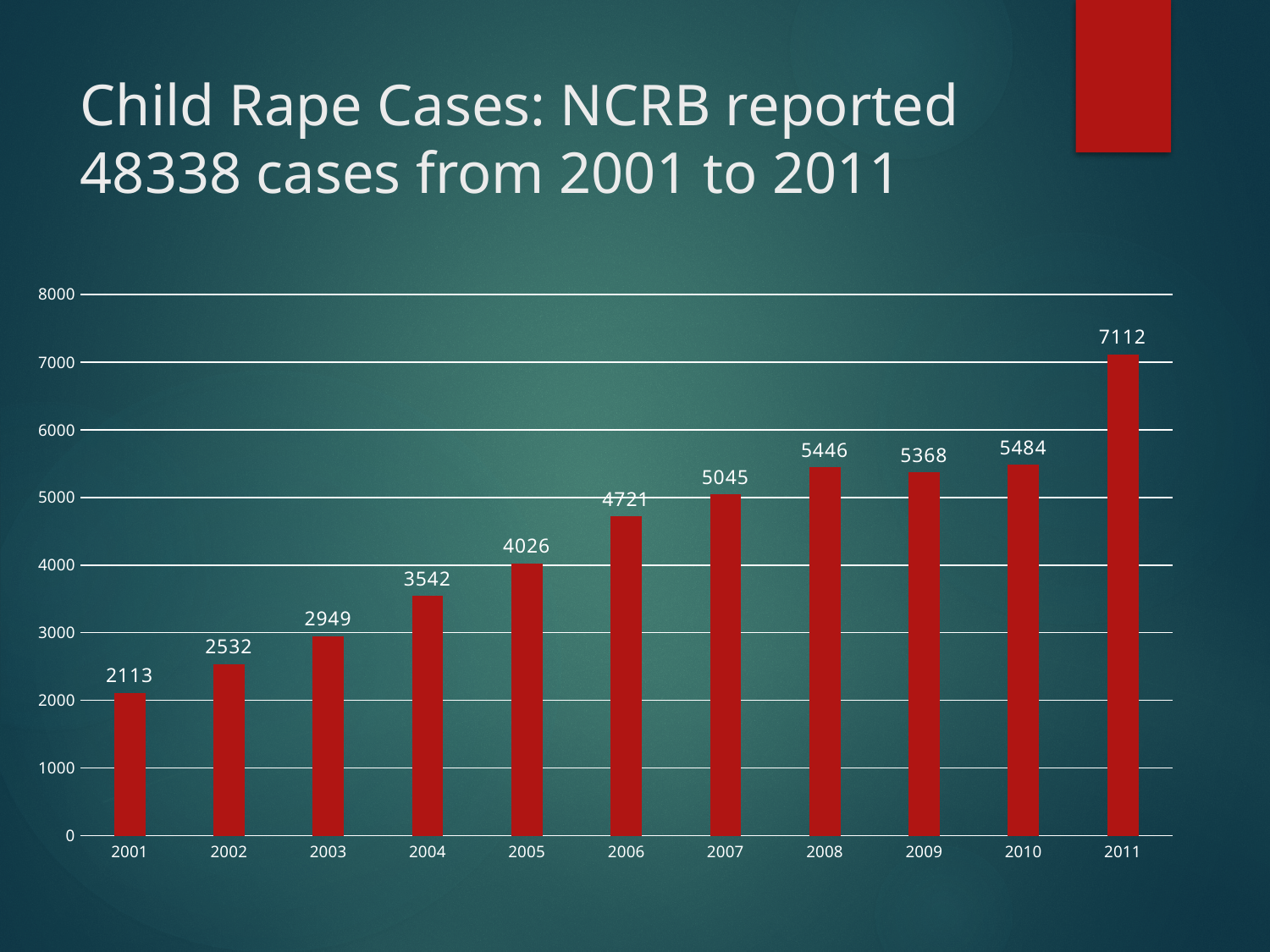
Is the value for 2007 greater or less than 5000? greater Do the values generally rise or fall from 2001 to 2011? rise What value is shown for 2009? 5368 What value is shown for 2001? 2113 What is the difference between the values for 2005 and 2004? 484 Which year has the highest value? 2011 Which is larger, the value for 2008 or the value for 2009? 2008 Which year has the lowest value? 2001 What value is shown for 2006? 4721 What kind of chart is shown on the slide? bar chart What is the difference between the values for 2011 and 2010? 1628 How many years are shown on the x axis? 11